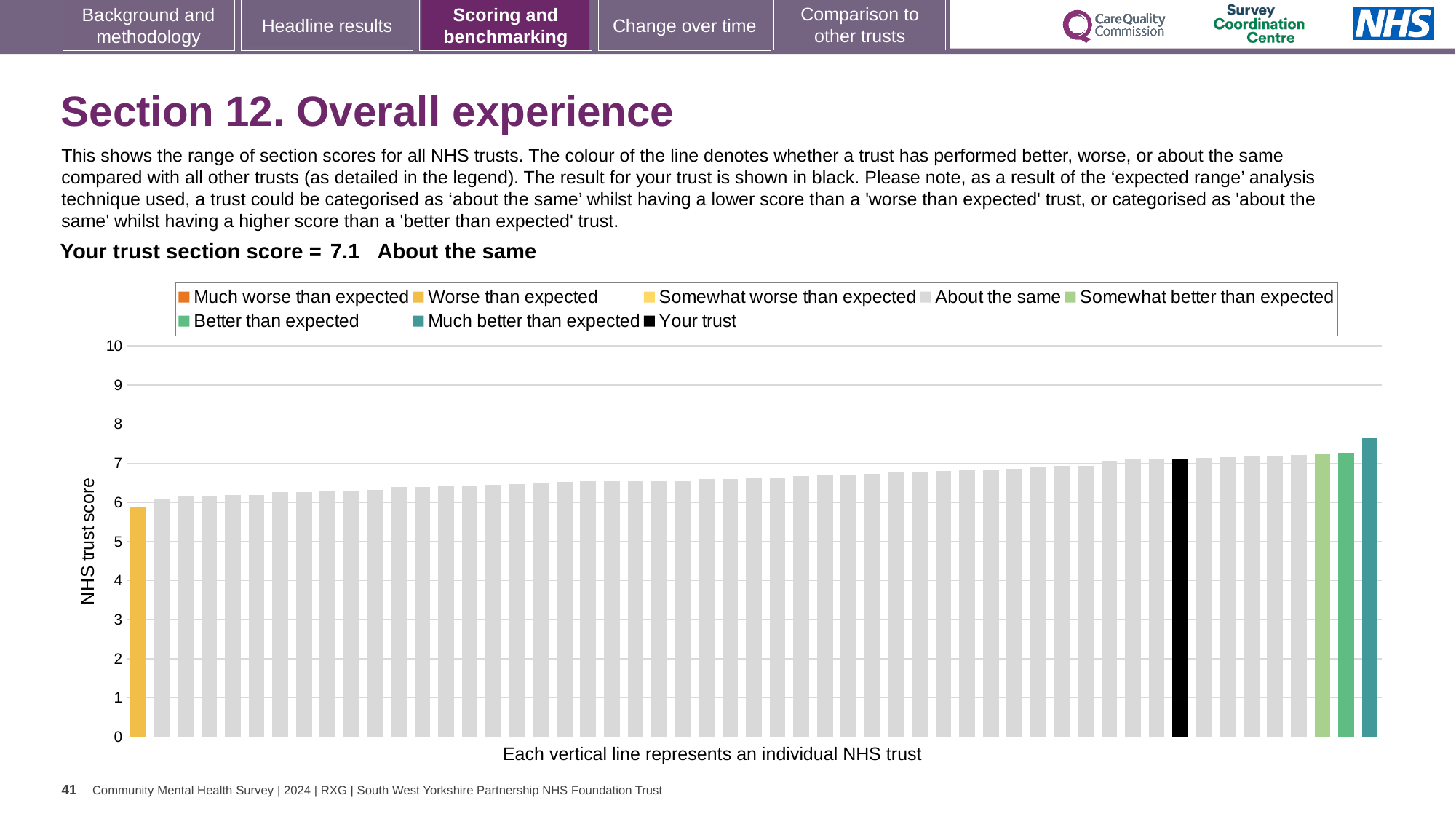
Is the value of the tallest bar greater or less than 8? less Which legend category does the shortest bar belong to? Worse than expected Is the value for your trust greater or less than 7? greater How many entries does the chart legend list? 8 Which legend category does the tallest bar belong to? Much better than expected Which performance category is your trust placed in? About the same How many bars are coloured as 'Much better than expected'? 1 What is the section score for your trust shown on the slide? 7.1 Do the bar values rise or fall from left to right along the x axis? rise What colour is the bar representing your trust? black What kind of chart is shown on the slide? bar chart Is the value of the shortest bar greater or less than 5? greater